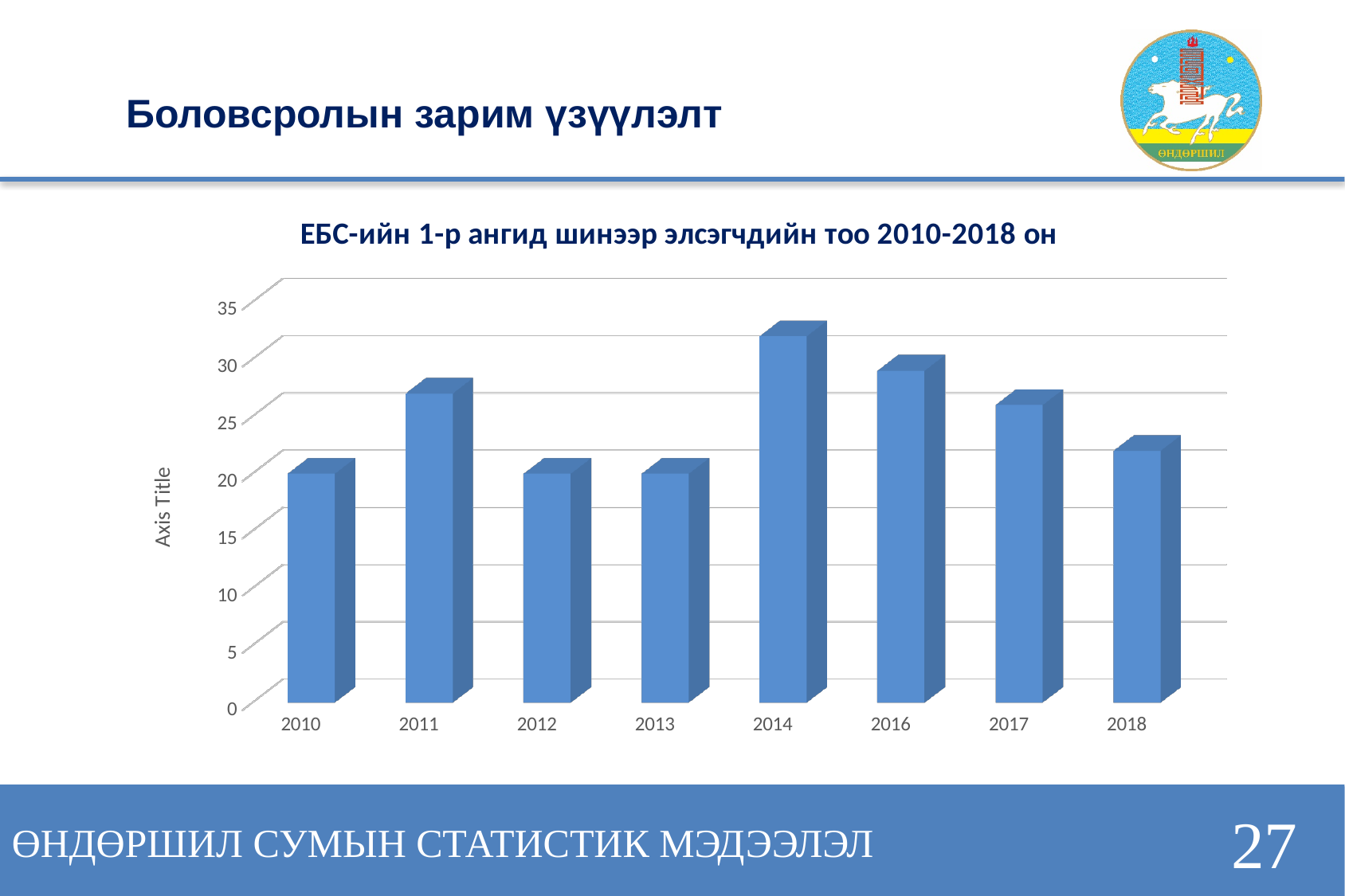
What kind of chart is shown on the slide? bar chart Is the value for 2011 greater or less than 25? greater How many years are shown on the x axis of the chart? 8 Which is larger, the value for 2014 or the value for 2016? 2014 Is the value for 2012 greater or less than 25? less What is the label on the vertical axis of the chart? Axis Title Is the value for 2014 greater or less than 30? greater Which is larger, the value for 2011 or the value for 2018? 2011 What is the title of the chart? ЕБС-ийн 1-р ангид шинээр элсэгчдийн тоо 2010-2018 он Which year has the highest number of new first-grade enrolments? 2014